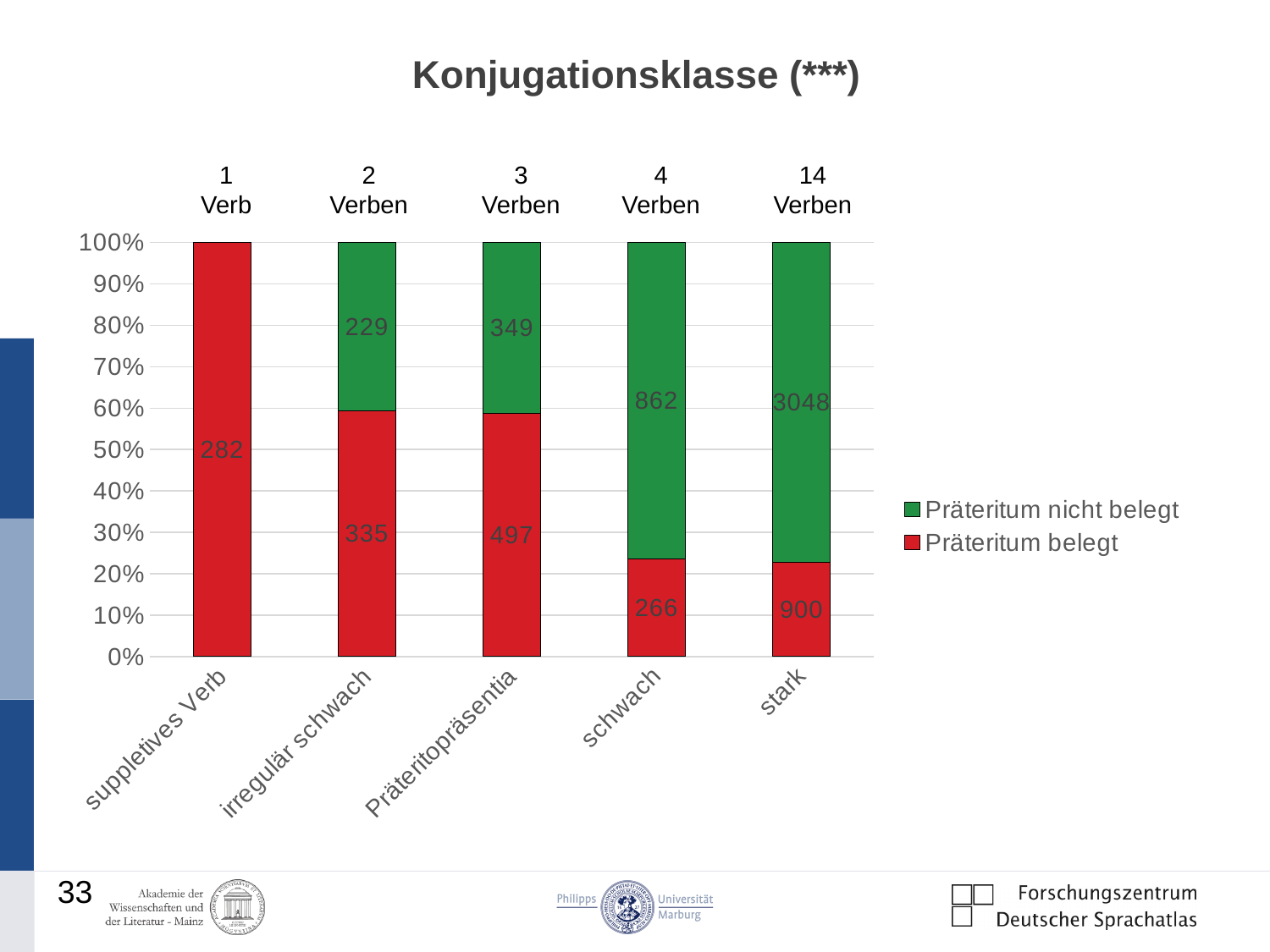
What kind of chart is shown on the slide? stacked bar chart Is the share of Präteritum belegt for the category schwach greater or less than 30%? less Which is larger for irregulär schwach: Präteritum belegt or Präteritum nicht belegt? Präteritum belegt Which category has the lowest value for Präteritum belegt? schwach What is the total of the two values for the category Präteritopräsentia? 846 How many series does the legend list? 2 What is the value of Präteritum belegt for the category stark? 900 What is the value of Präteritum nicht belegt for the category schwach? 862 How many categories are shown on the x axis? 5 Which category has the highest value for Präteritum nicht belegt? stark What is the value of Präteritum belegt for Präteritopräsentia? 497 What is the difference between Präteritum nicht belegt and Präteritum belegt for the category stark? 2148